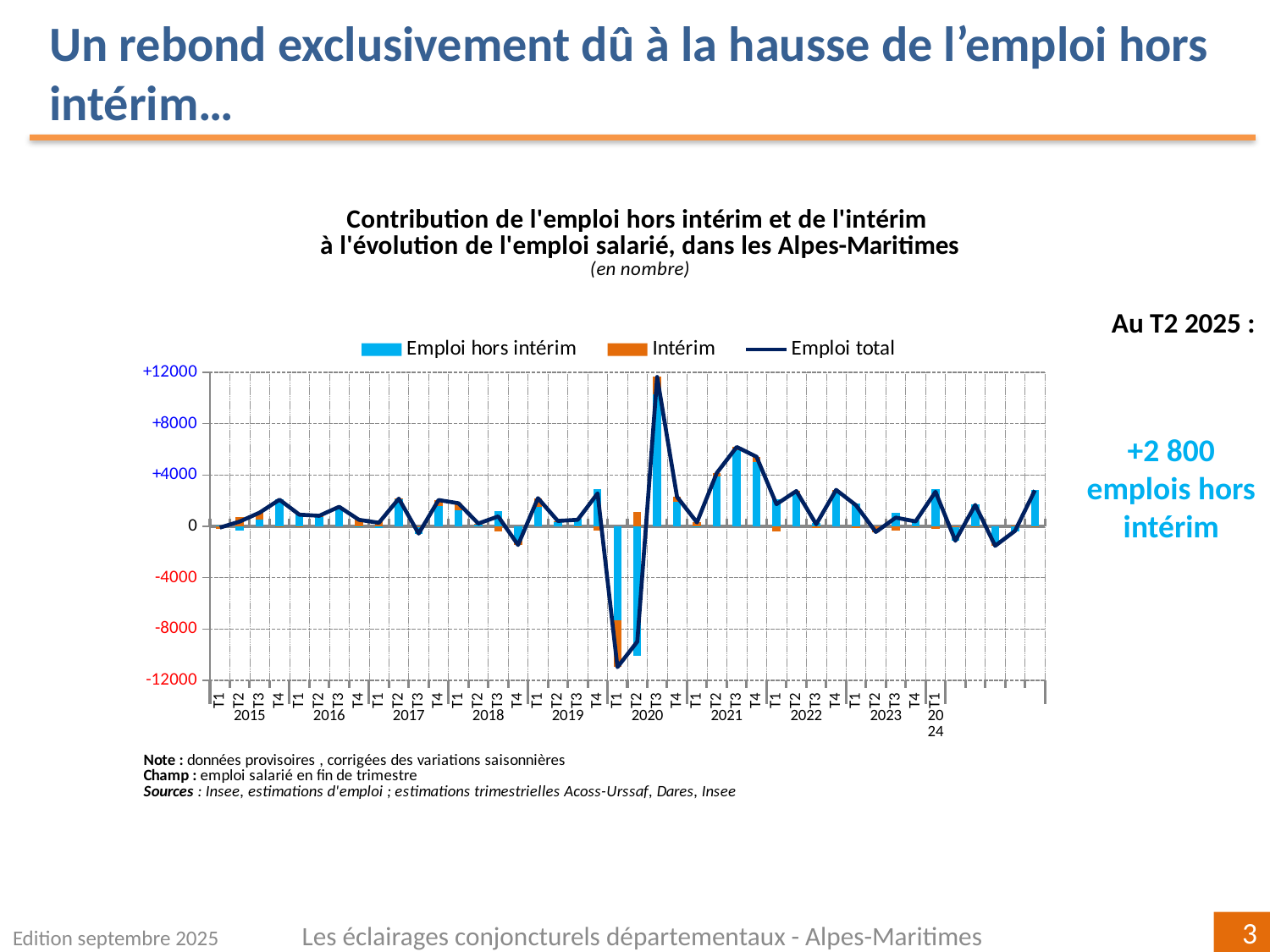
What kind of chart is shown on the slide? Combined bar and line chart In which quarter does the 'Emploi total' line reach its lowest value? T1 2020 What is the highest value shown on the chart's vertical axis? +12000 In which quarter does the 'Emploi total' line reach its highest value? T3 2020 What are the three series named in the chart legend? Emploi hors intérim, Intérim, Emploi total Is the 'Emploi hors intérim' value for T3 2020 greater or less than +8000? greater According to the slide, what is the value of 'Emploi hors intérim' at T2 2025? +2 800 Which is larger for 'Emploi hors intérim': T3 2020 or T3 2021? T3 2020 How many series does the chart legend list? 3 Is the 'Emploi hors intérim' value for T3 2021 greater or less than +4000? greater Is the 'Emploi hors intérim' value for T2 2020 greater or less than -8000? less